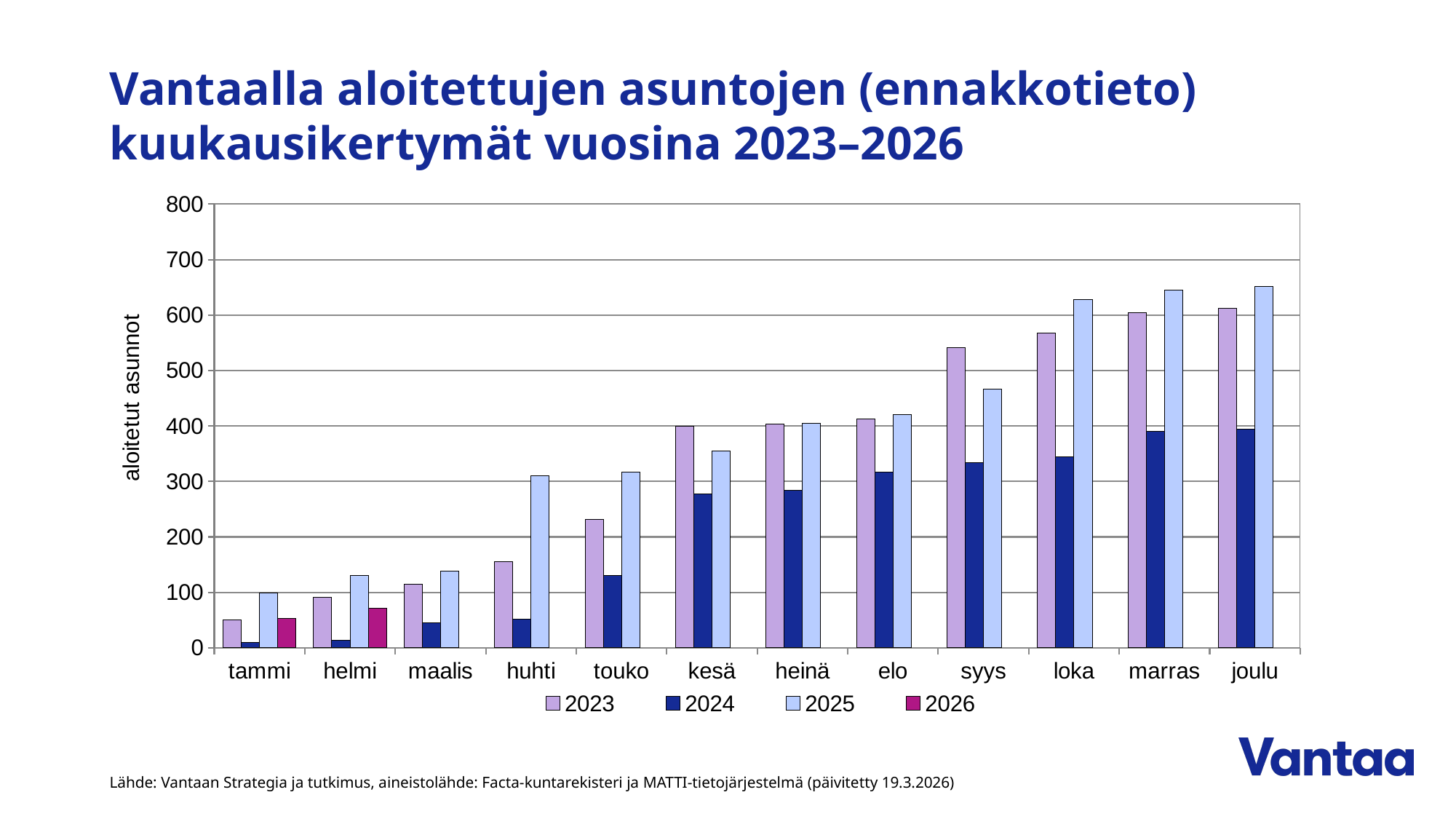
How many months are shown on the x axis? 12 Is the 2024 value for tammi greater or less than 100? less Is the 2025 value for joulu greater or less than 600? greater What kind of chart is shown on the slide? bar chart Is the 2023 value for syys greater or less than 500? greater How many series does the legend list? 4 For how many months is a 2026 bar plotted? 2 Which month has the lowest 2023 value? tammi Do the 2025 values rise or fall from tammi to joulu? rise Which is larger for huhti, the 2023 value or the 2025 value? 2025 Which is larger for touko, the 2024 value or the 2025 value? 2025 Which series has the highest value in joulu? 2025